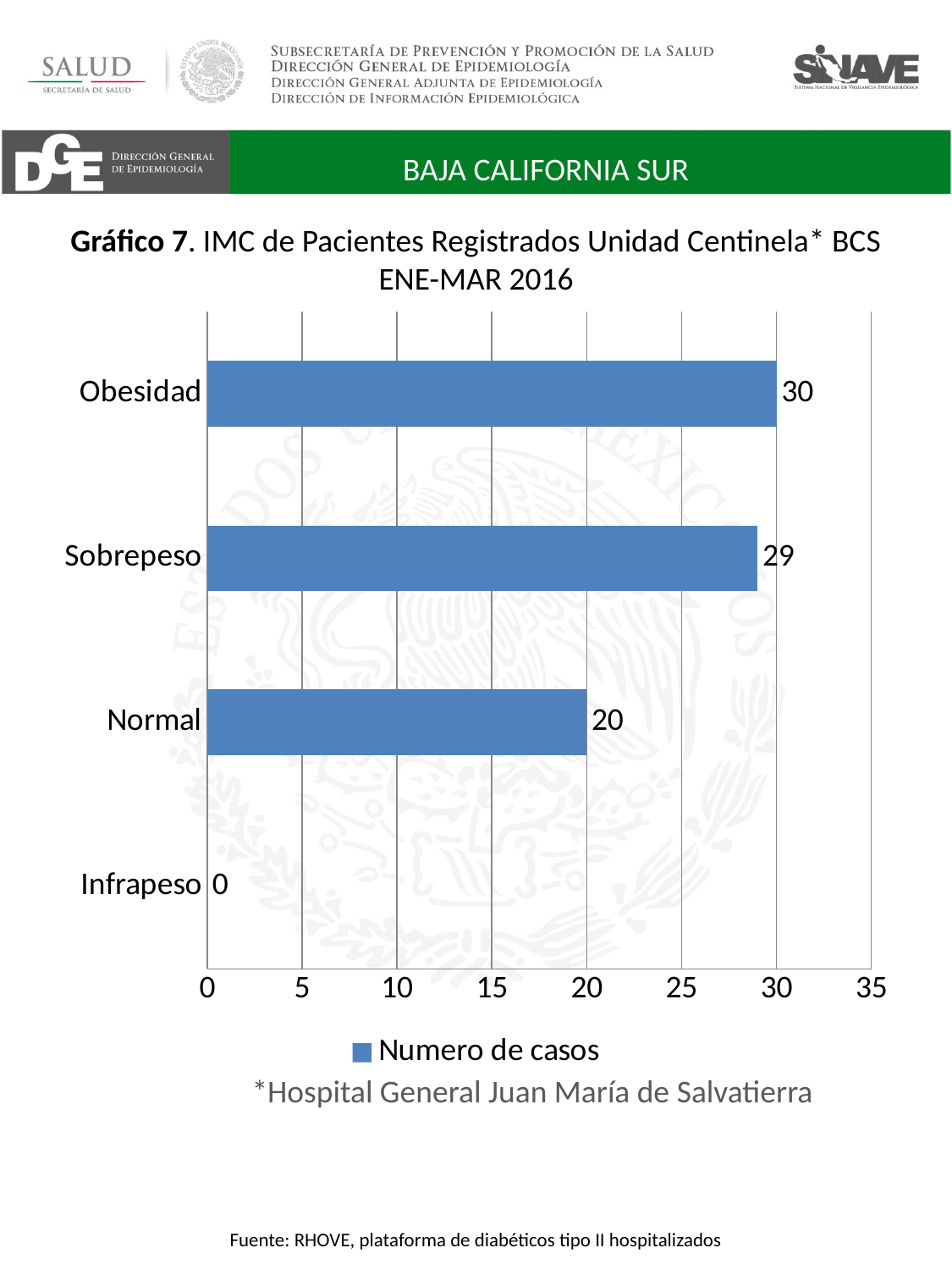
Which has more cases, Normal or Sobrepeso? Sobrepeso What is the number of cases for Obesidad? 30 What is the number of cases for Sobrepeso? 29 What is the number of cases for Infrapeso? 0 What series name does the legend show? Numero de casos How many BMI categories are shown in the chart? 4 What is the difference in number of cases between Sobrepeso and Normal? 9 Which BMI category has the highest number of cases? Obesidad Which BMI category has the lowest number of cases? Infrapeso What is the number of cases for Normal? 20 What is the difference in number of cases between Obesidad and Normal? 10 What type of chart is shown on the slide? Bar chart